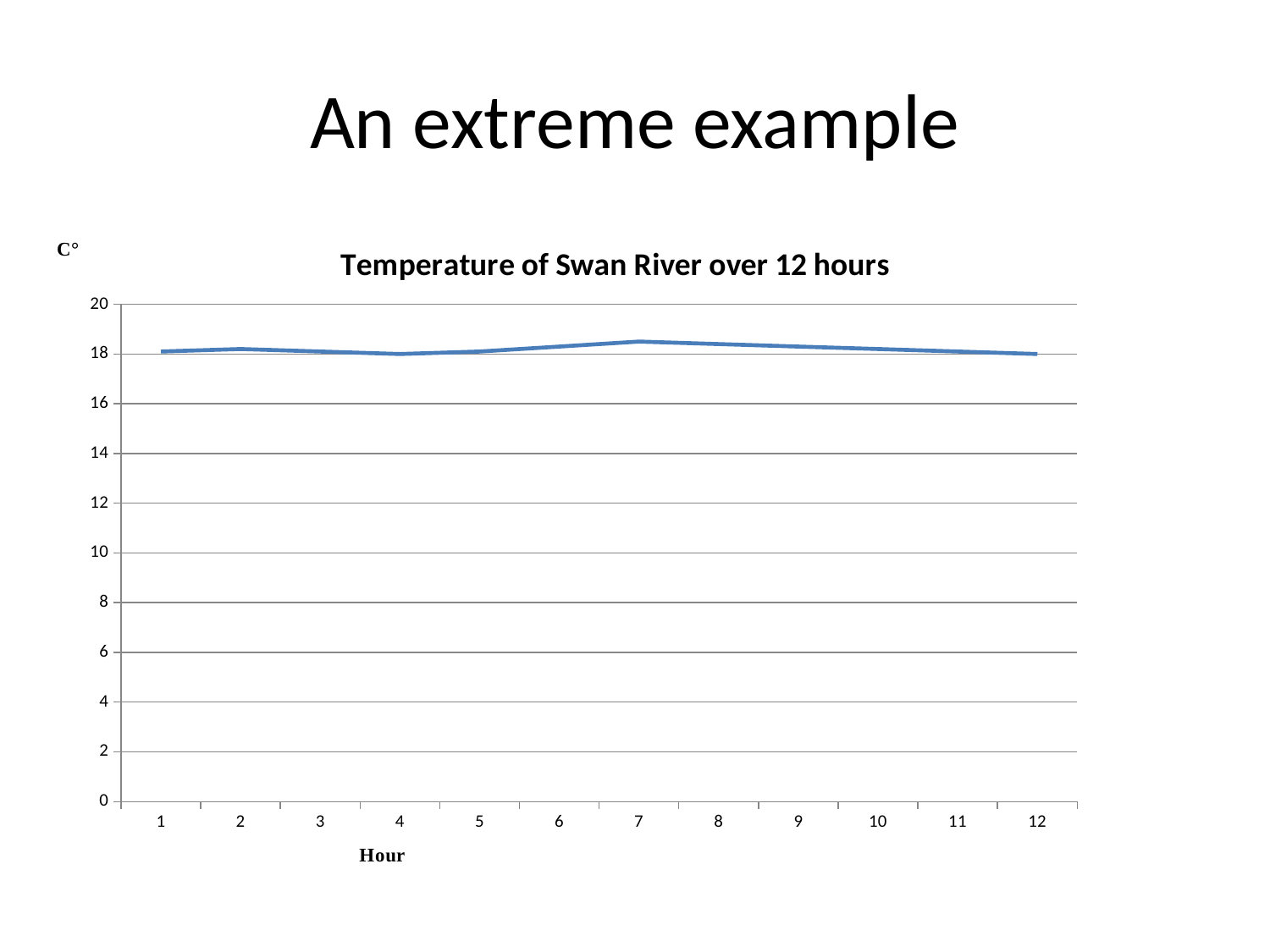
What is the title of the chart? Temperature of Swan River over 12 hours At which hour does the temperature reach its highest point? 7 Is the value for hour 10 greater or less than 14? greater What is the highest value shown on the y axis? 20 What kind of chart is shown on the slide? line chart What is the label on the x axis? Hour Is the value for hour 1 greater or less than 20? less Is the value for hour 7 greater or less than 16? greater How many hours (data points) are plotted on the x axis? 12